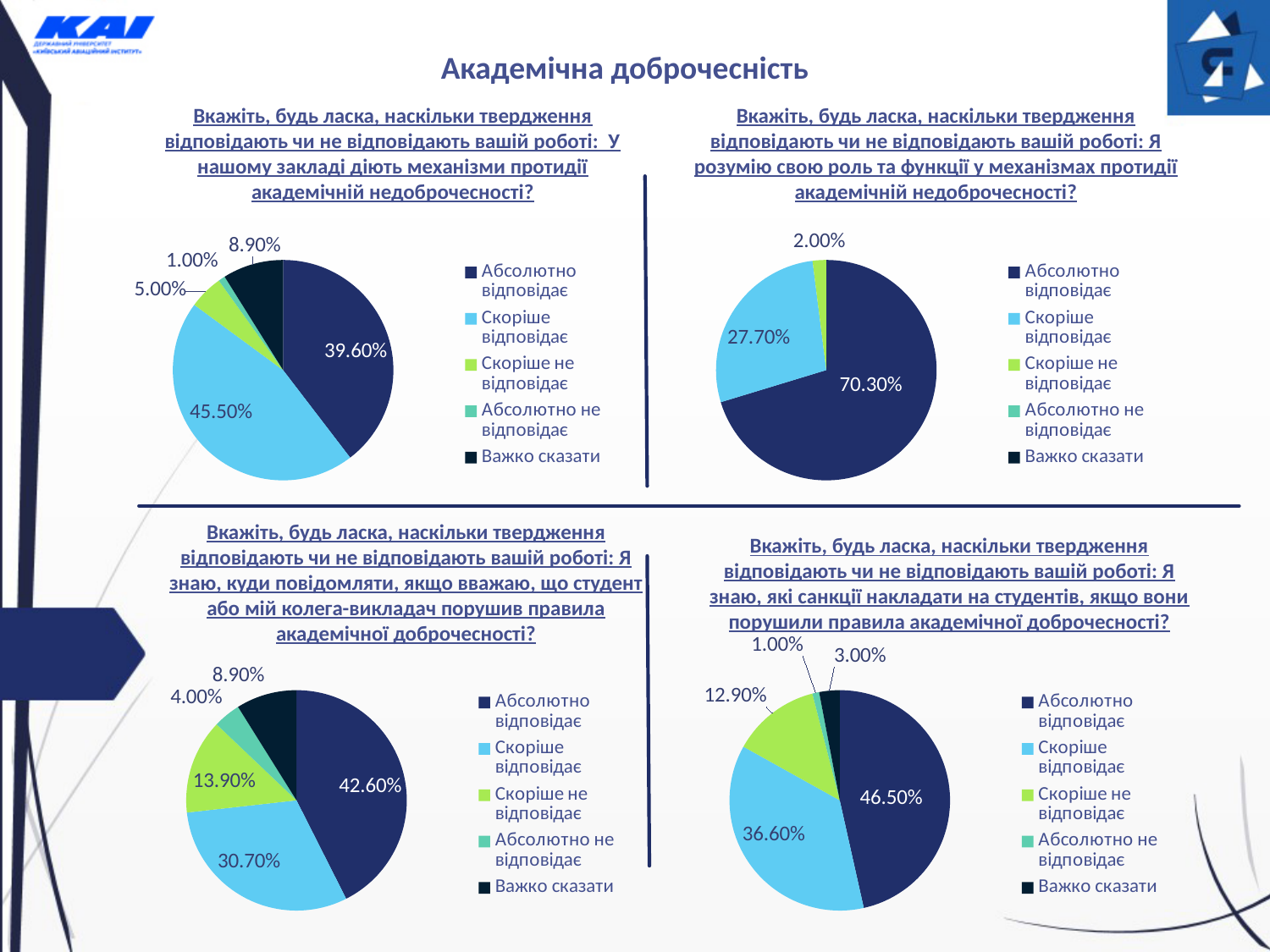
In the bottom-right pie chart, what percentage is shown for "Важко сказати"? 3.00% In the bottom-left pie chart, what percentage is shown for "Скоріше не відповідає"? 13.90% In the bottom-left pie chart, which is larger: "Абсолютно відповідає" or "Скоріше відповідає"? Абсолютно відповідає In the top-right pie chart, what percentage is shown for "Скоріше відповідає"? 27.70% In the top-left pie chart, what percentage is shown for "Скоріше відповідає"? 45.50% How many entries does the legend of the bottom-right chart list? 5 In the bottom-right pie chart, what percentage is shown for "Абсолютно відповідає"? 46.50% In the top-left pie chart, what is the difference between "Скоріше відповідає" and "Абсолютно відповідає"? 5.90% In the top-right pie chart, what percentage is shown for "Абсолютно відповідає"? 70.30% In the top-right pie chart, which category has the smallest labelled share? Скоріше не відповідає What type of chart is used in the top-left panel of the slide? Pie chart In the top-left pie chart, which category has the largest share? Скоріше відповідає